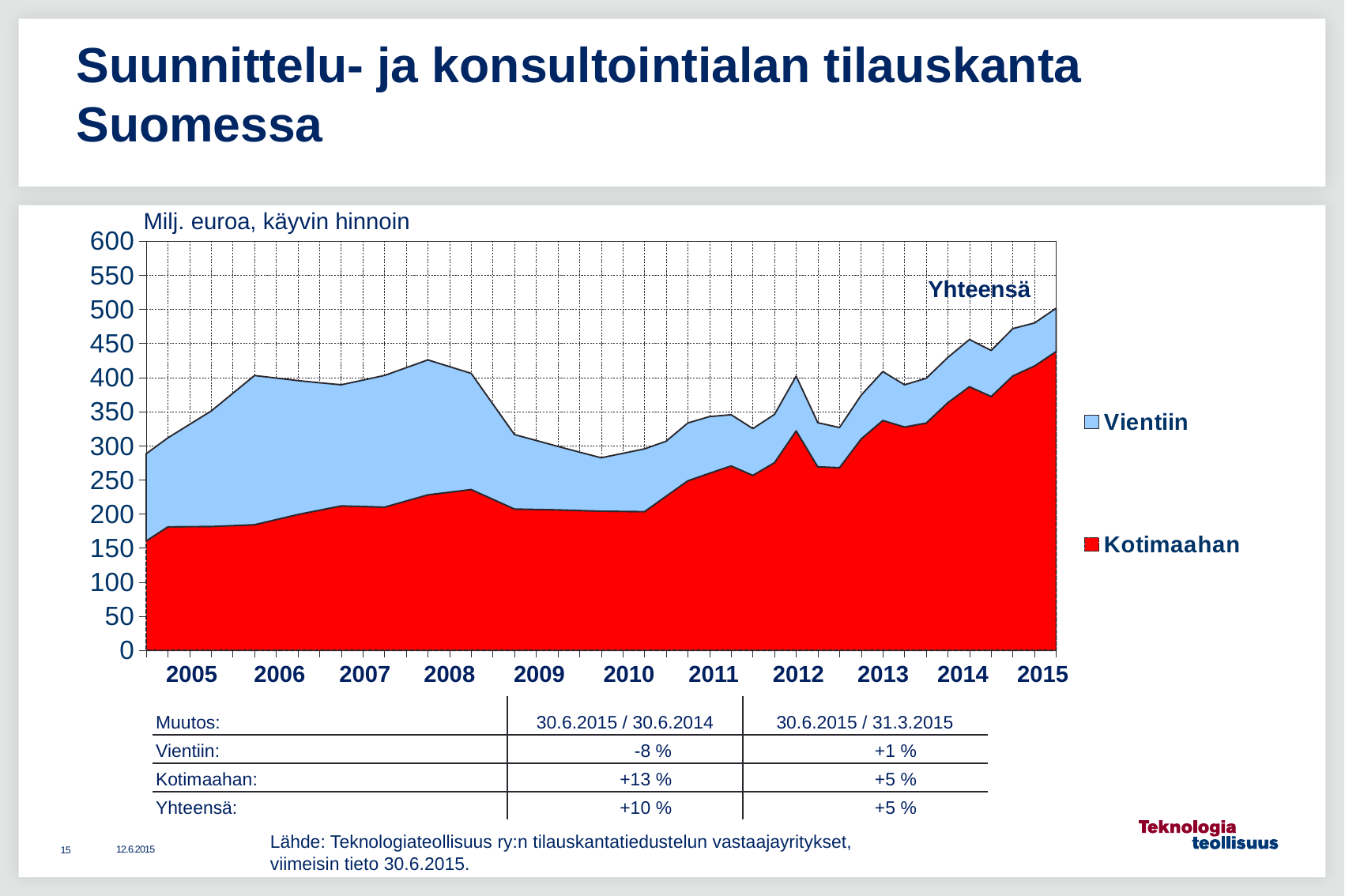
Is the Kotimaahan value in 2010 greater or less than 250? less Is the total (Yhteensä) value at the end of 2015 greater or less than 450? greater Which series is larger in 2015, Vientiin or Kotimaahan? Kotimaahan What kind of chart is shown on the slide? Stacked area chart According to the table below the chart, what is the change for Kotimaahan between 30.6.2014 and 30.6.2015? +13 % Is the Kotimaahan value at the end of 2015 greater or less than 400? greater Which two series are listed in the chart legend? Vientiin and Kotimaahan How many year labels are shown on the x axis? 11 What unit is stated above the chart's y axis? Milj. euroa, käyvin hinnoin How many series does the chart legend list? 2 Does the Kotimaahan value rise or fall from 2010 to 2015? rise